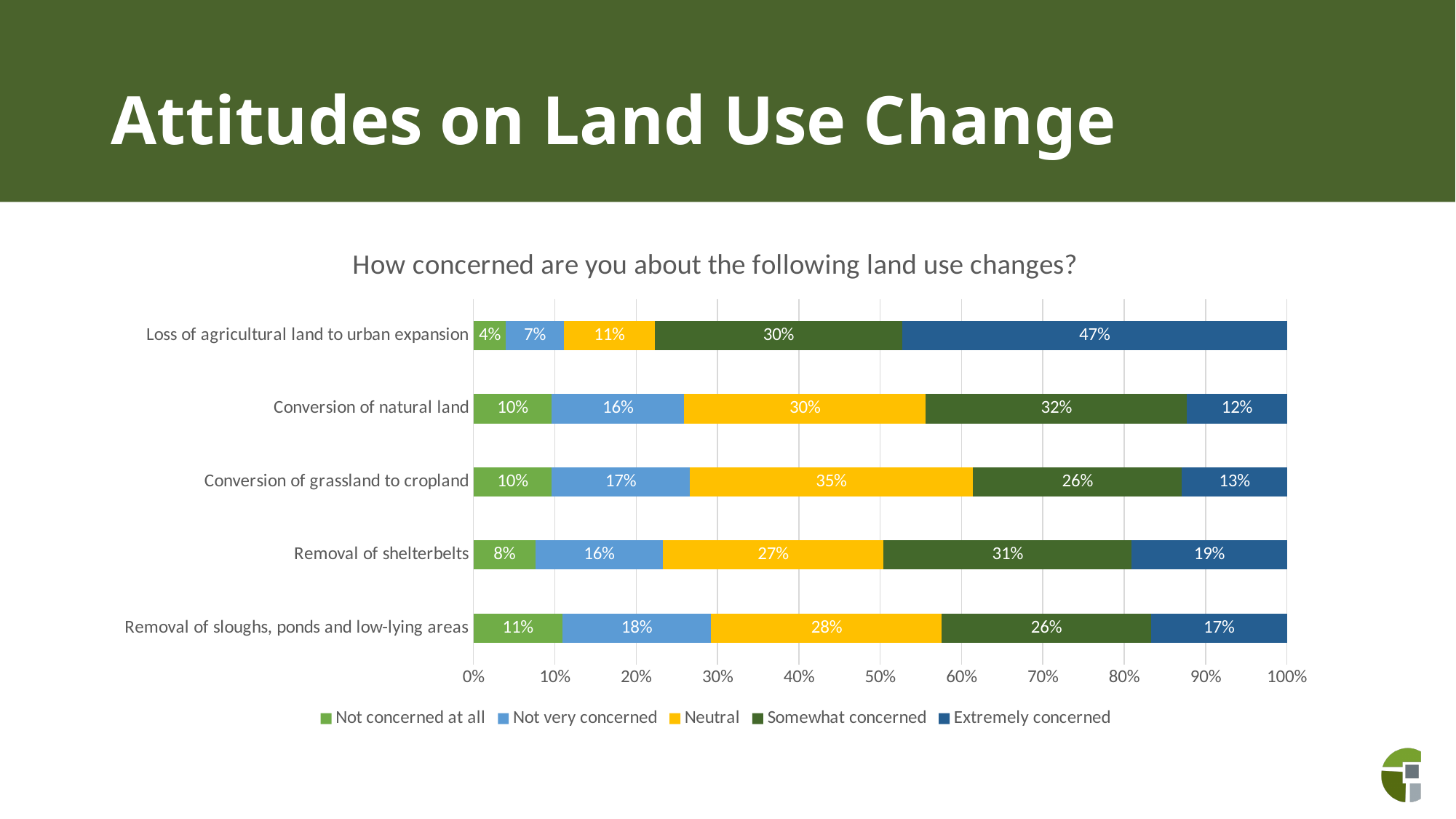
What kind of chart is shown on the slide? Stacked bar chart What is the combined percentage of Somewhat concerned and Extremely concerned for conversion of grassland to cropland? 39% How many land use changes are listed on the chart? 5 What is the Neutral value for conversion of grassland to cropland? 35% Which land use change has the lowest Not concerned at all percentage? Loss of agricultural land to urban expansion What percentage of respondents are extremely concerned about loss of agricultural land to urban expansion? 47% Which has a larger Neutral share: conversion of natural land or removal of shelterbelts? Conversion of natural land What is the difference between the Extremely concerned values for removal of shelterbelts and conversion of natural land? 7% Which land use change has the highest Extremely concerned percentage? Loss of agricultural land to urban expansion What is the Somewhat concerned value for removal of shelterbelts? 31% How many series does the legend list? 5 What percentage are not concerned at all about removal of sloughs, ponds and low-lying areas? 11%